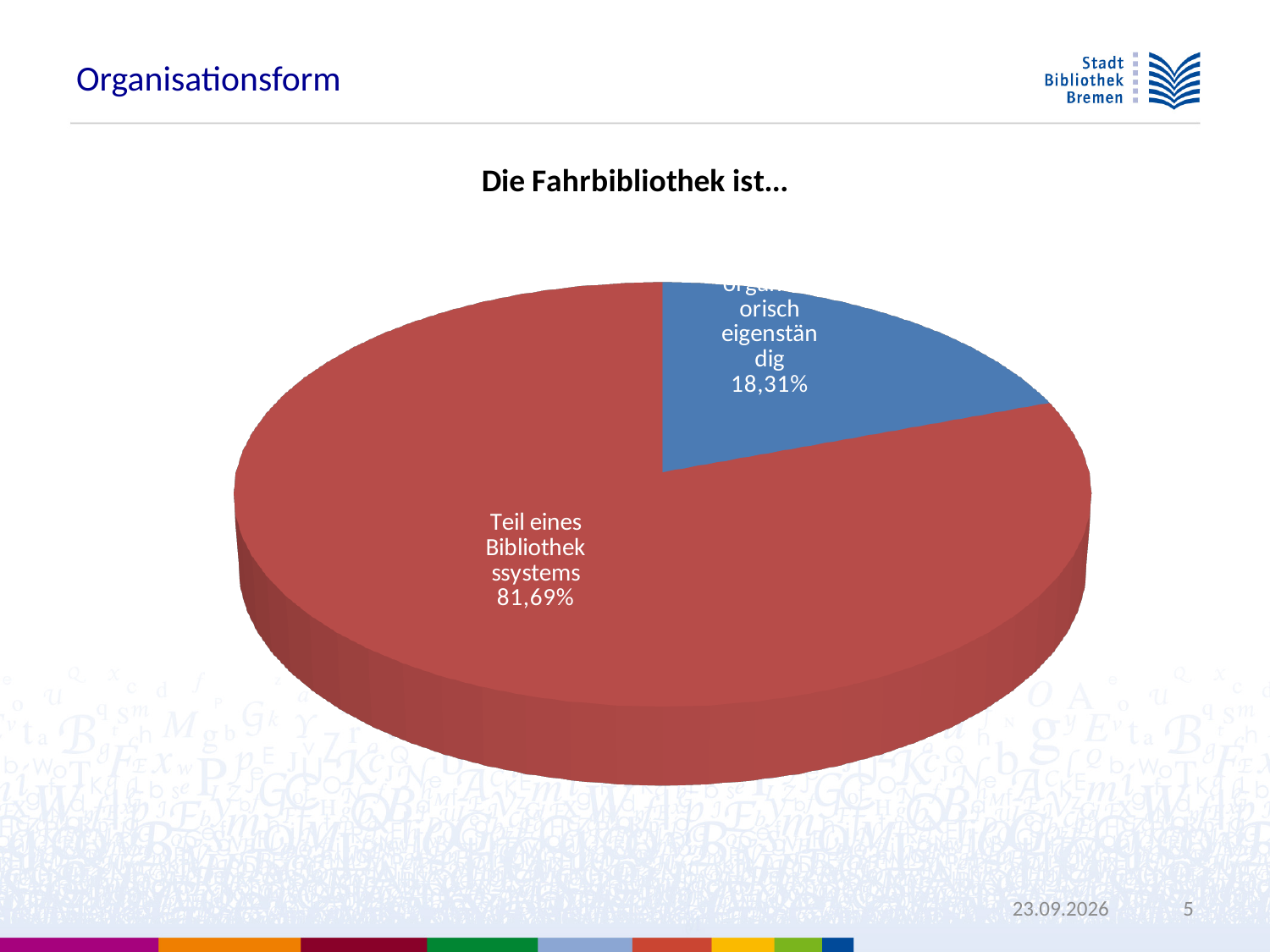
What percentage is shown for the blue slice? 18,31% Which colour is the slice for "Teil eines Bibliothekssystems"? red How many slices does the pie chart have? 2 What percentage is shown for the slice labelled "Teil eines Bibliothekssystems"? 81,69% Is the share of "Teil eines Bibliothekssystems" larger or smaller than the share of the blue slice? larger What is the title of the chart? Die Fahrbibliothek ist... Which slice is the largest in the pie chart? Teil eines Bibliothekssystems What is the difference in percentage points between the two slices? 63,38 What kind of chart is shown on the slide? pie chart What share of the pie does the "Teil eines Bibliothekssystems" slice represent? 81,69% Which slice is the smallest in the pie chart? the blue slice (organisatorisch eigenständig)